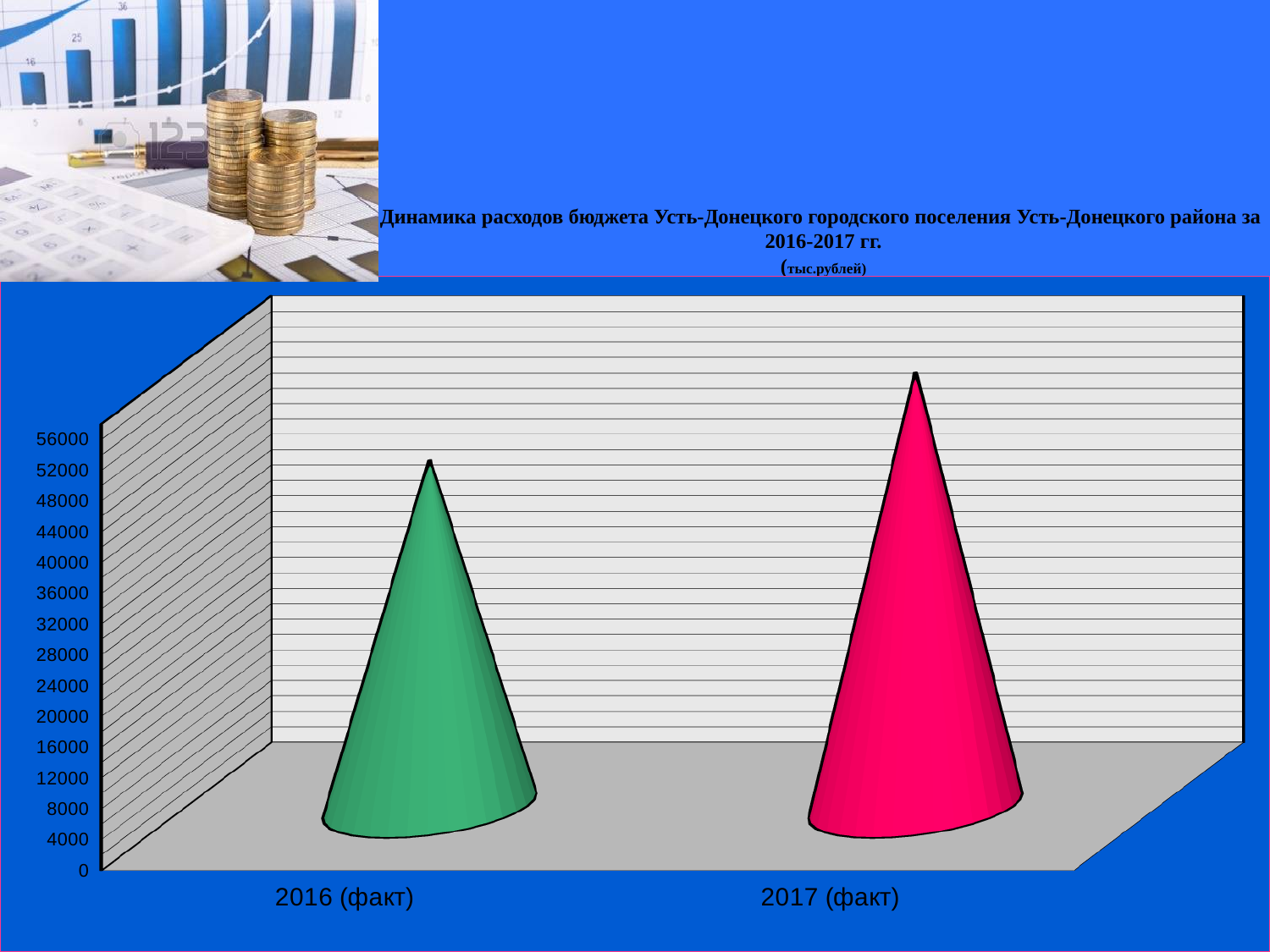
In what units are the values in the chart expressed, according to the title? тыс.рублей What kind of chart is shown on the slide? bar chart How many categories are plotted on the x axis of the chart? 2 Is the value for 2016 (факт) greater or less than 56000? less Do the values rise or fall from 2016 (факт) to 2017 (факт)? rise Which category has the lowest value in the chart? 2016 (факт) What is the highest value labelled on the vertical axis of the chart? 56000 Is the value for 2016 (факт) greater or less than 20000? greater Which is larger, the value for 2016 (факт) or the value for 2017 (факт)? 2017 (факт) Is the value for 2017 (факт) greater or less than 40000? greater Which category has the highest value in the chart? 2017 (факт)